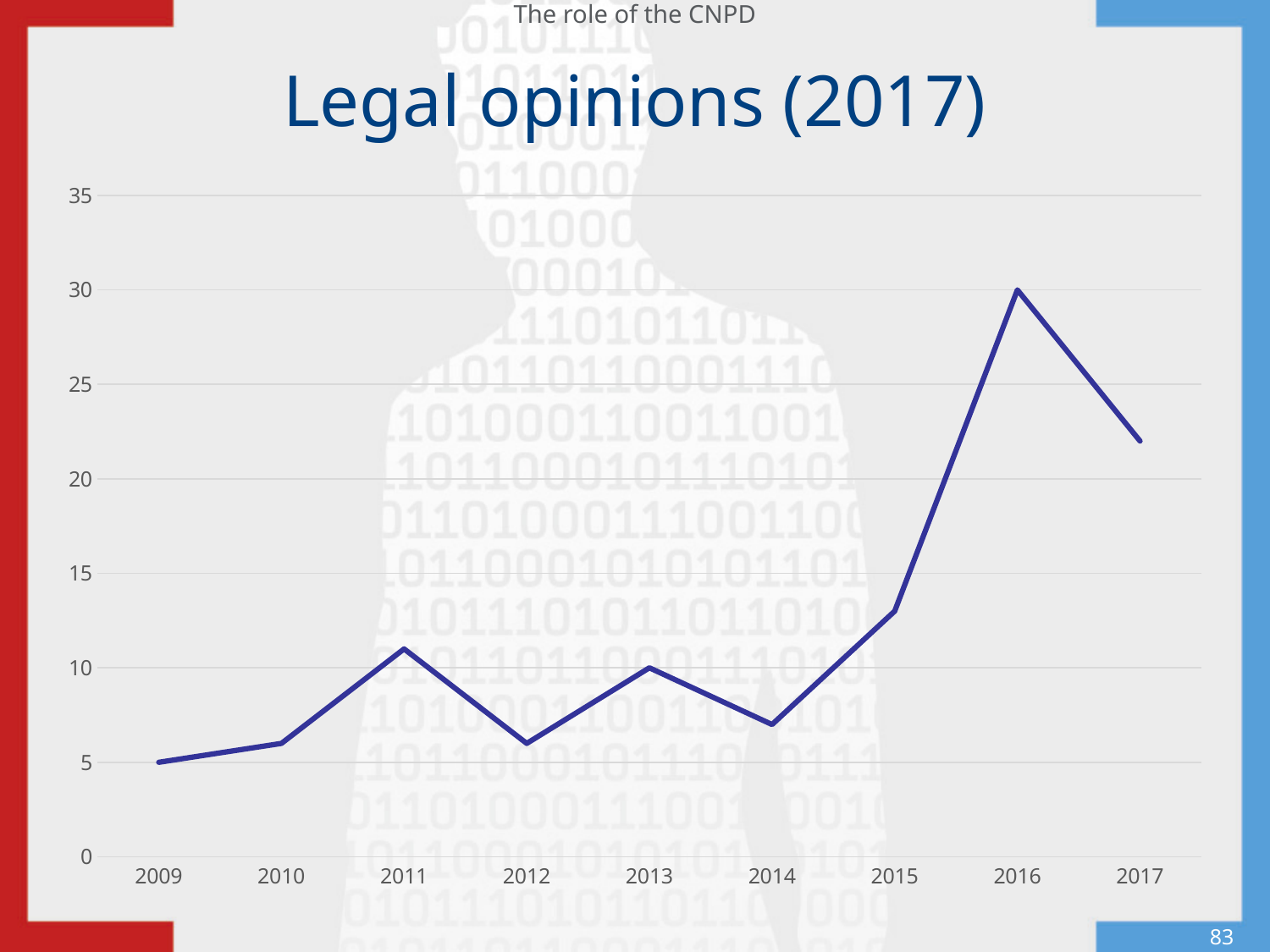
What is the value for 2009? 5 What is the title of the chart on the slide? Legal opinions (2017) What is the value for 2016? 30 Is the value for 2017 greater or less than 20? greater Which year has the larger value, 2011 or 2014? 2011 What kind of chart is shown on the slide? line chart Does the value rise or fall from 2016 to 2017? fall What is the value for 2013? 10 Is the value for 2015 greater or less than 15? less Which year has the lowest value in the chart? 2009 Which year has the highest value in the chart? 2016 How many years are plotted along the x axis of the chart? 9